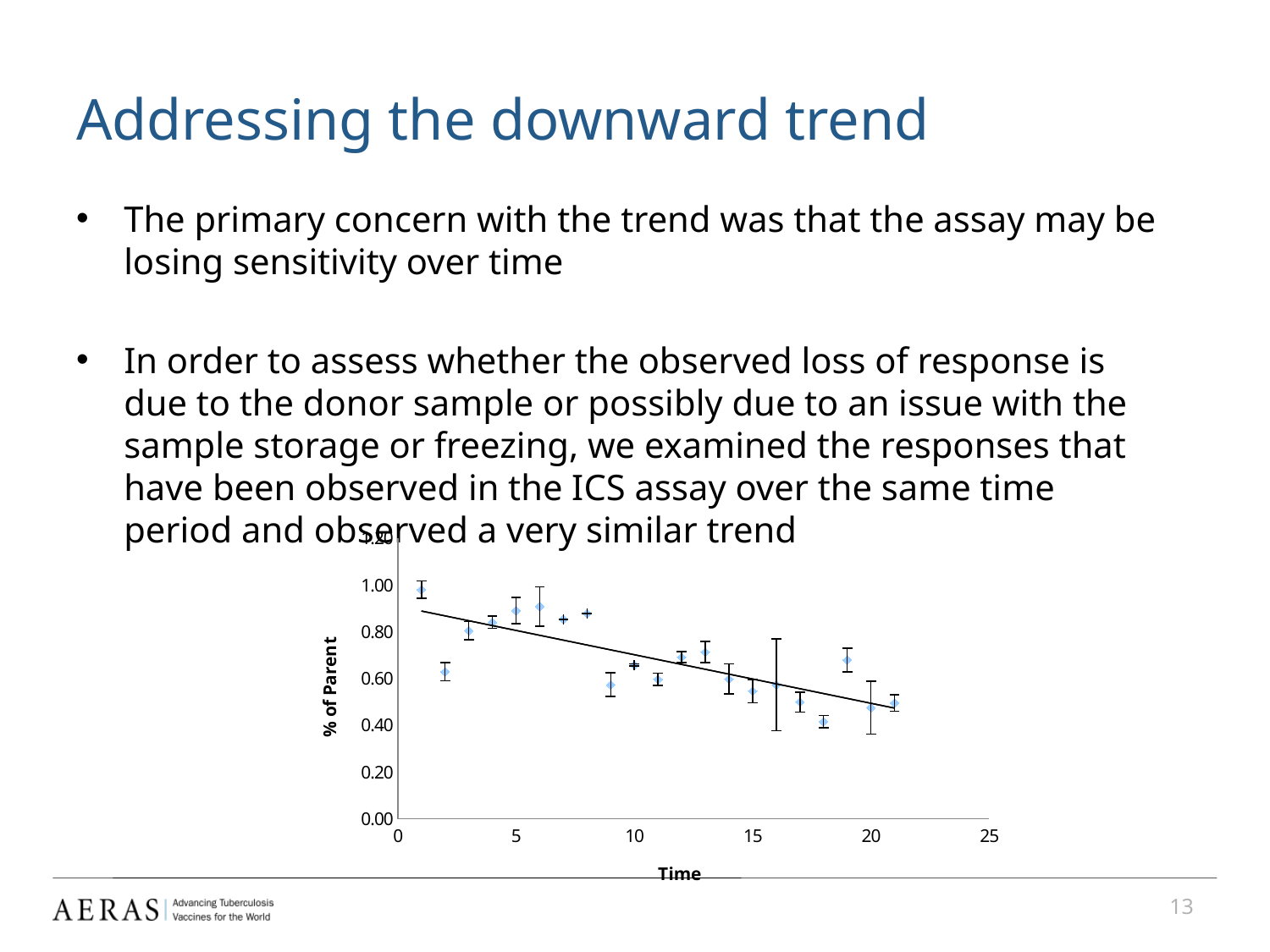
Is the value for Time 6 greater or less than 0.80? greater Do the plotted values generally rise or fall as Time increases? Fall At which Time is the plotted value highest? 1 Is the value for Time 9 greater or less than 0.80? less Which has the larger value, Time 6 or Time 18? Time 6 Is the value for Time 18 greater or less than 0.60? less What is the label of the horizontal axis of the chart? Time What is the label of the vertical axis of the chart? % of Parent How many data points are plotted on the chart? 21 What kind of chart is shown on the slide? Scatter chart